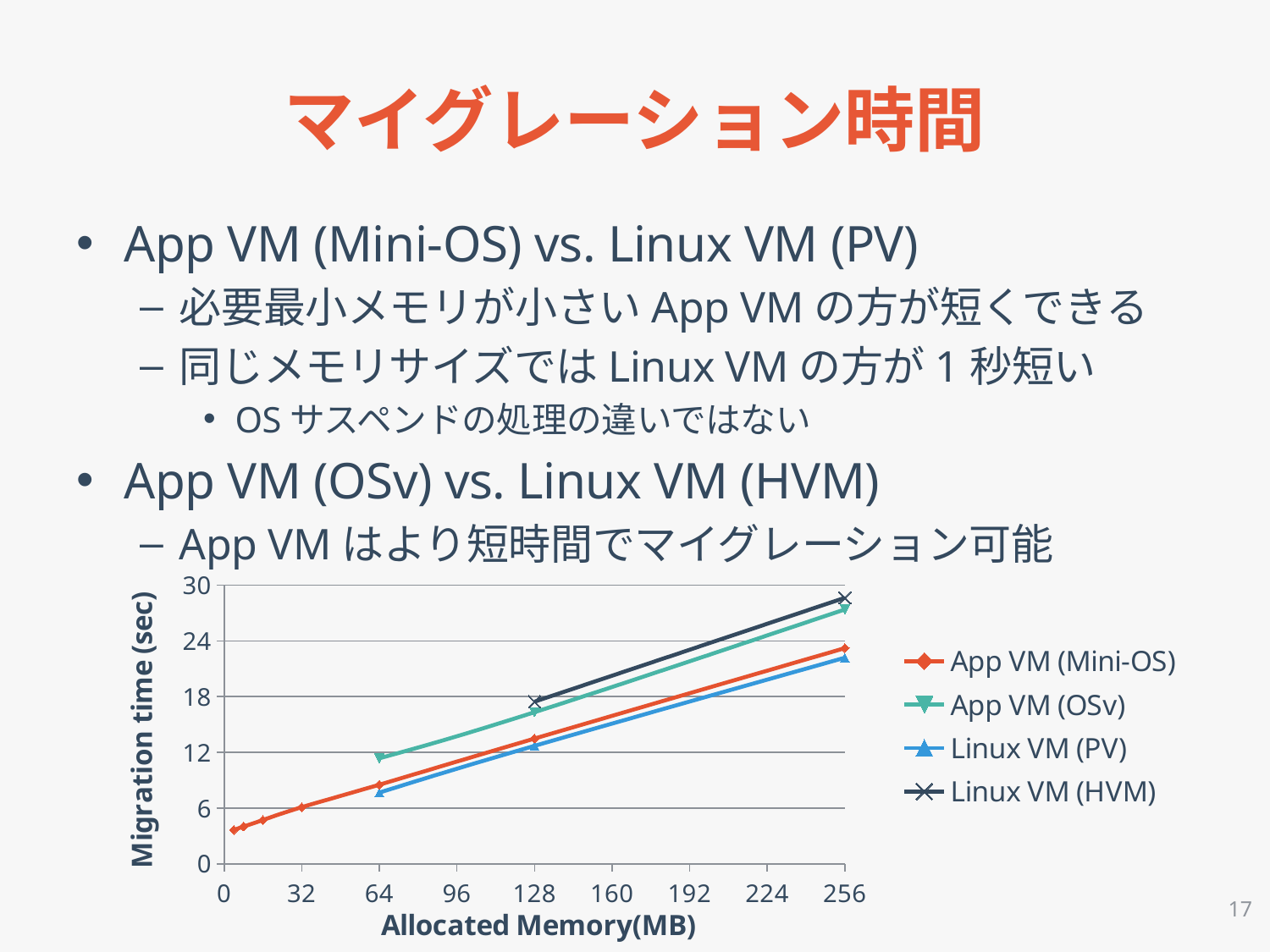
Is the migration time for App VM (Mini-OS) at 32 MB greater or less than 12? less Is the migration time for App VM (OSv) at 256 MB greater or less than 24? greater At 128 MB, which has the longer migration time: Linux VM (HVM) or Linux VM (PV)? Linux VM (HVM) What is the label of the y axis of the chart? Migration time (sec) What kind of chart is shown on the slide? line chart Is the migration time for Linux VM (HVM) at 128 MB greater or less than 12? greater How many series does the chart legend list? 4 Does the migration time for App VM (Mini-OS) rise or fall as allocated memory increases? rise What is the label of the x axis of the chart? Allocated Memory(MB) At 256 MB, which has the longer migration time: App VM (OSv) or App VM (Mini-OS)? App VM (OSv) Does the migration time for Linux VM (HVM) rise or fall as allocated memory increases? rise